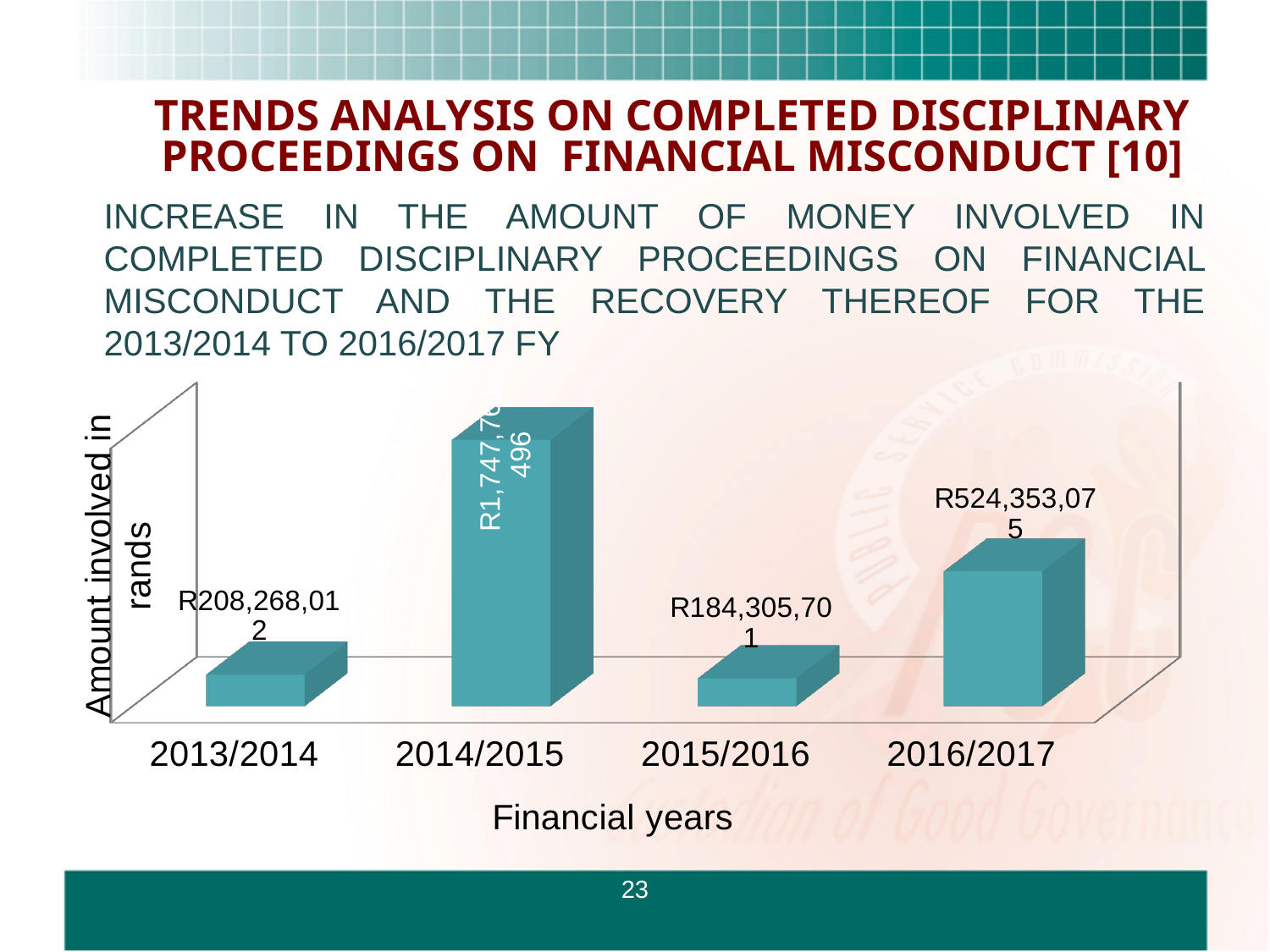
Which financial year has the lowest amount involved? 2015/2016 What is the difference between the amounts for 2013/2014 and 2015/2016? R23,962,311 What is the amount involved for 2016/2017? R524,353,075 What is the title of the x axis of the chart? Financial years What is the amount involved for 2015/2016? R184,305,701 What kind of chart is shown on the slide? Bar chart Which financial year has the highest amount involved? 2014/2015 What is the difference between the amounts for 2016/2017 and 2013/2014? R316,085,063 Which is larger, the amount for 2016/2017 or the amount for 2013/2014? 2016/2017 Does the amount involved rise or fall from 2015/2016 to 2016/2017? Rise How many financial years are shown on the chart? 4 What is the amount involved for 2013/2014? R208,268,012